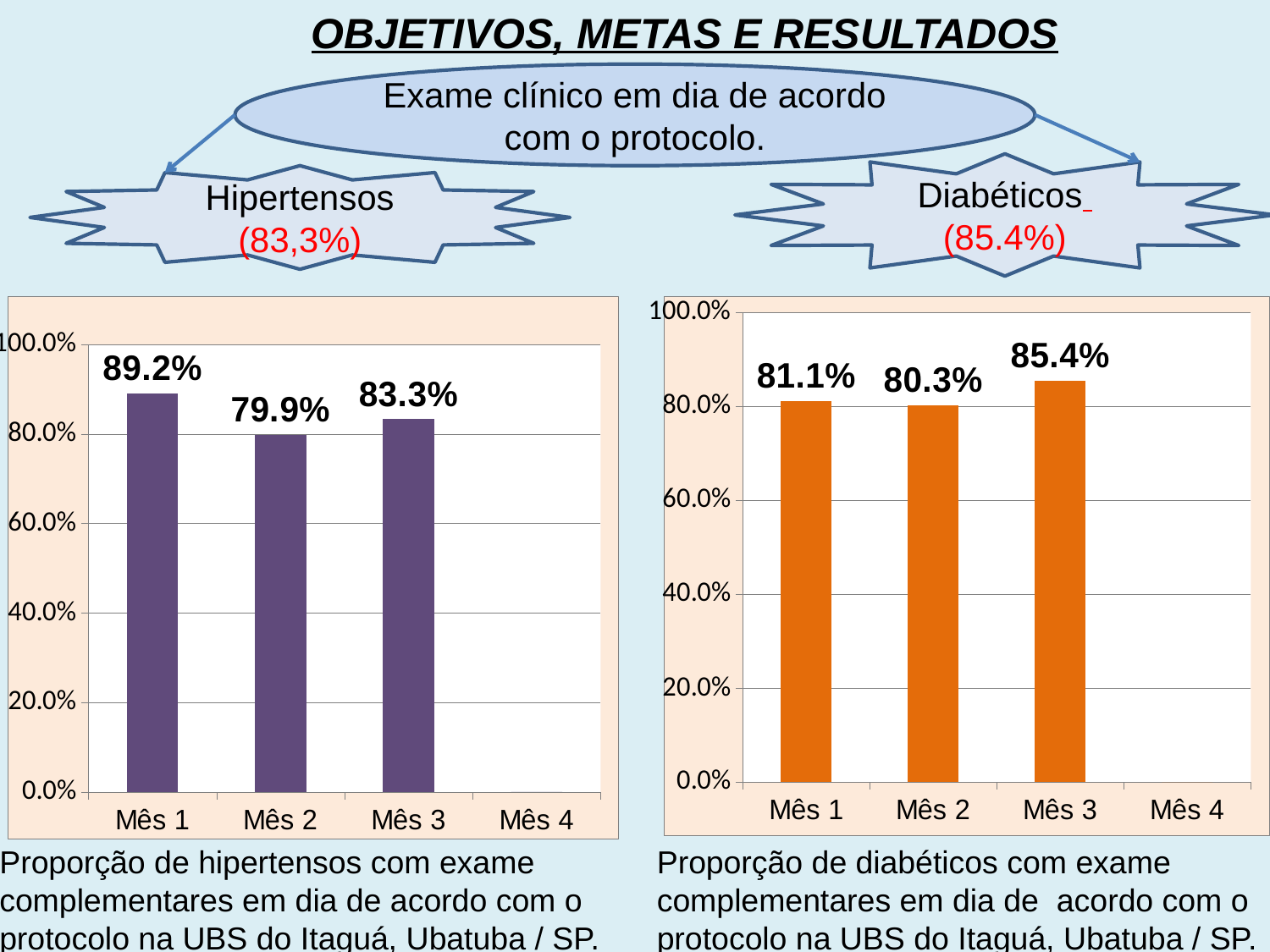
In the left chart (hipertensos), what is the value for Mês 1? 89.2% In the right chart (diabéticos), what is the value for Mês 2? 80.3% In the right chart (diabéticos), is the value for Mês 1 larger or smaller than the value for Mês 3? smaller In the left chart (hipertensos), which month has the highest value? Mês 1 What type of chart is the right chart (diabéticos)? bar chart In the right chart (diabéticos), what is the difference between the values for Mês 3 and Mês 1? 4.3% In the left chart (hipertensos), what is the difference between the values for Mês 1 and Mês 2? 9.3% In the right chart (diabéticos), what is the value for Mês 3? 85.4% In the left chart (hipertensos), what is the value for Mês 2? 79.9% How many bars are plotted in the left chart (hipertensos)? 3 In the left chart (hipertensos), which month has the lowest plotted value? Mês 2 In the right chart (diabéticos), which month has the highest value? Mês 3